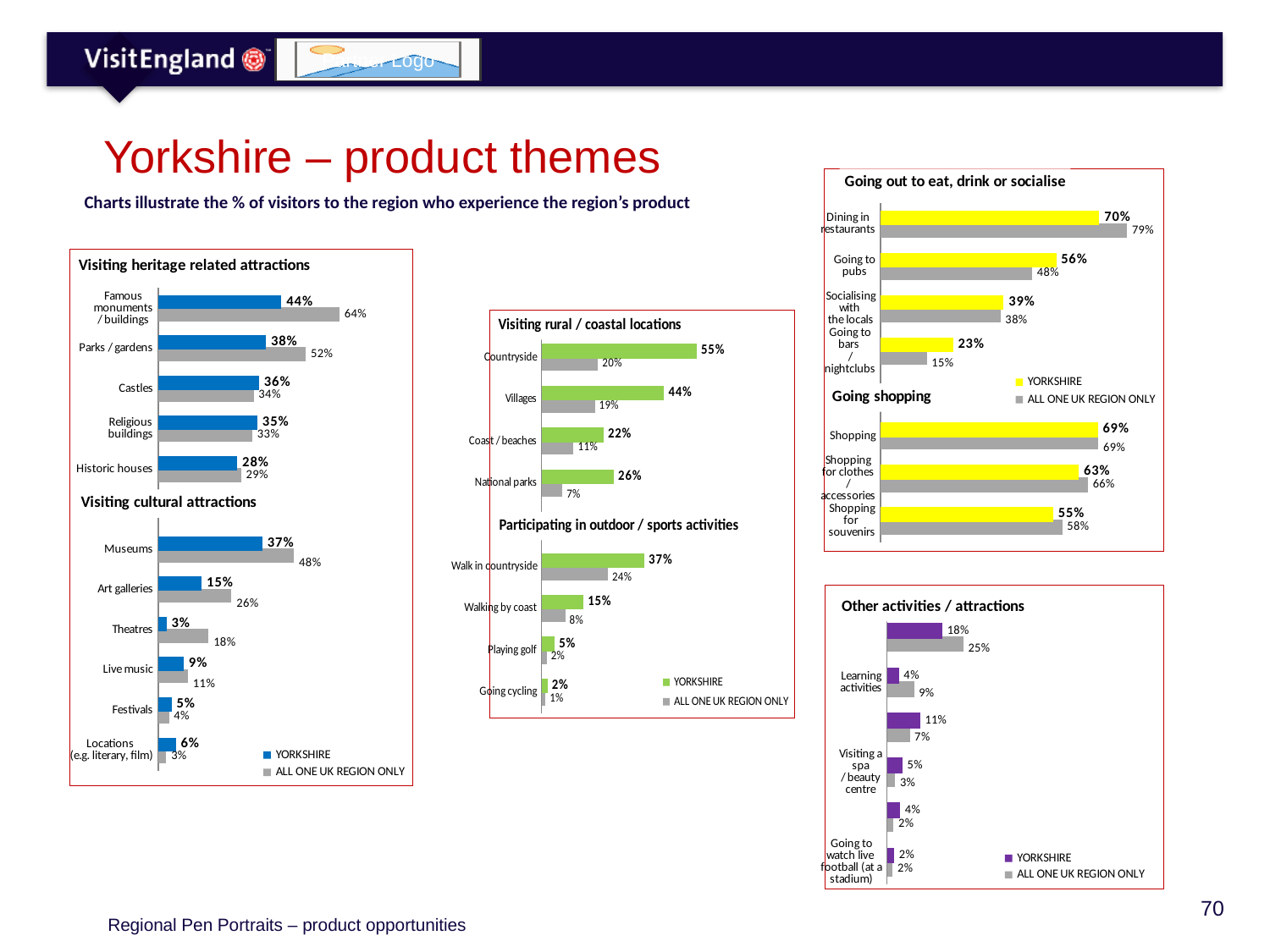
In the 'Participating in outdoor / sports activities' chart, which category has the lowest Yorkshire value? Going cycling In the 'Visiting cultural attractions' chart, what is the difference between the ALL ONE UK REGION ONLY value and the Yorkshire value for Theatres? 15% In the 'Visiting heritage related attractions' chart, what is the Yorkshire value for Castles? 36% In the 'Going shopping' chart, what is the ALL ONE UK REGION ONLY value for Shopping for souvenirs? 58% In the 'Visiting rural / coastal locations' chart, what is the Yorkshire value for Countryside? 55% In the 'Going out to eat, drink or socialise' chart, which is larger for Dining in restaurants: the Yorkshire value or the ALL ONE UK REGION ONLY value? ALL ONE UK REGION ONLY In the 'Visiting rural / coastal locations' chart, how many categories are shown? 4 In the 'Visiting heritage related attractions' chart, what is the ALL ONE UK REGION ONLY value for Famous monuments / buildings? 64% In the 'Other activities / attractions' chart, what is the ALL ONE UK REGION ONLY value for Learning activities? 9% How many series does the legend list in the 'Visiting heritage related attractions' chart? 2 In the 'Visiting cultural attractions' chart, which category has the highest Yorkshire value? Museums In the 'Going out to eat, drink or socialise' chart, what is the Yorkshire value for Going to pubs? 56%